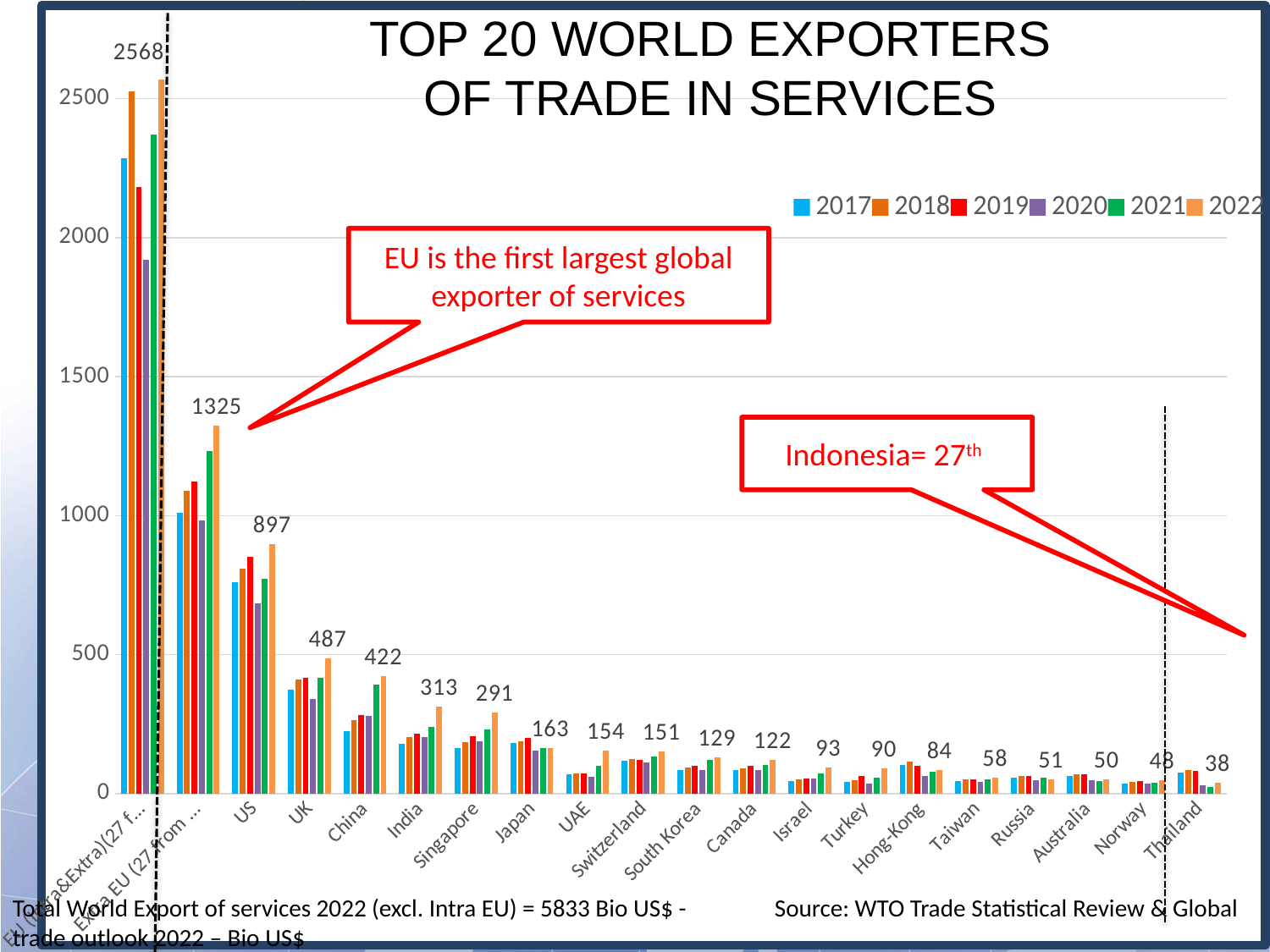
What is the difference between the labelled 2022 values for the US and the UK? 410 What is the labelled 2022 value for the US? 897 How many countries or regions are shown along the x axis? 20 Which has the larger labelled 2022 value, Singapore or Japan? Singapore Is the 2017 value for the US greater or less than 1000? less What is the title of the chart? TOP 20 WORLD EXPORTERS OF TRADE IN SERVICES What is the labelled 2022 value for Japan? 163 How many series does the legend list? 6 Which of the 20 exporters has the lowest labelled 2022 value? Thailand What is the labelled 2022 value for the UK? 487 What is the labelled 2022 value for Thailand? 38 What kind of chart is shown on the slide? bar chart